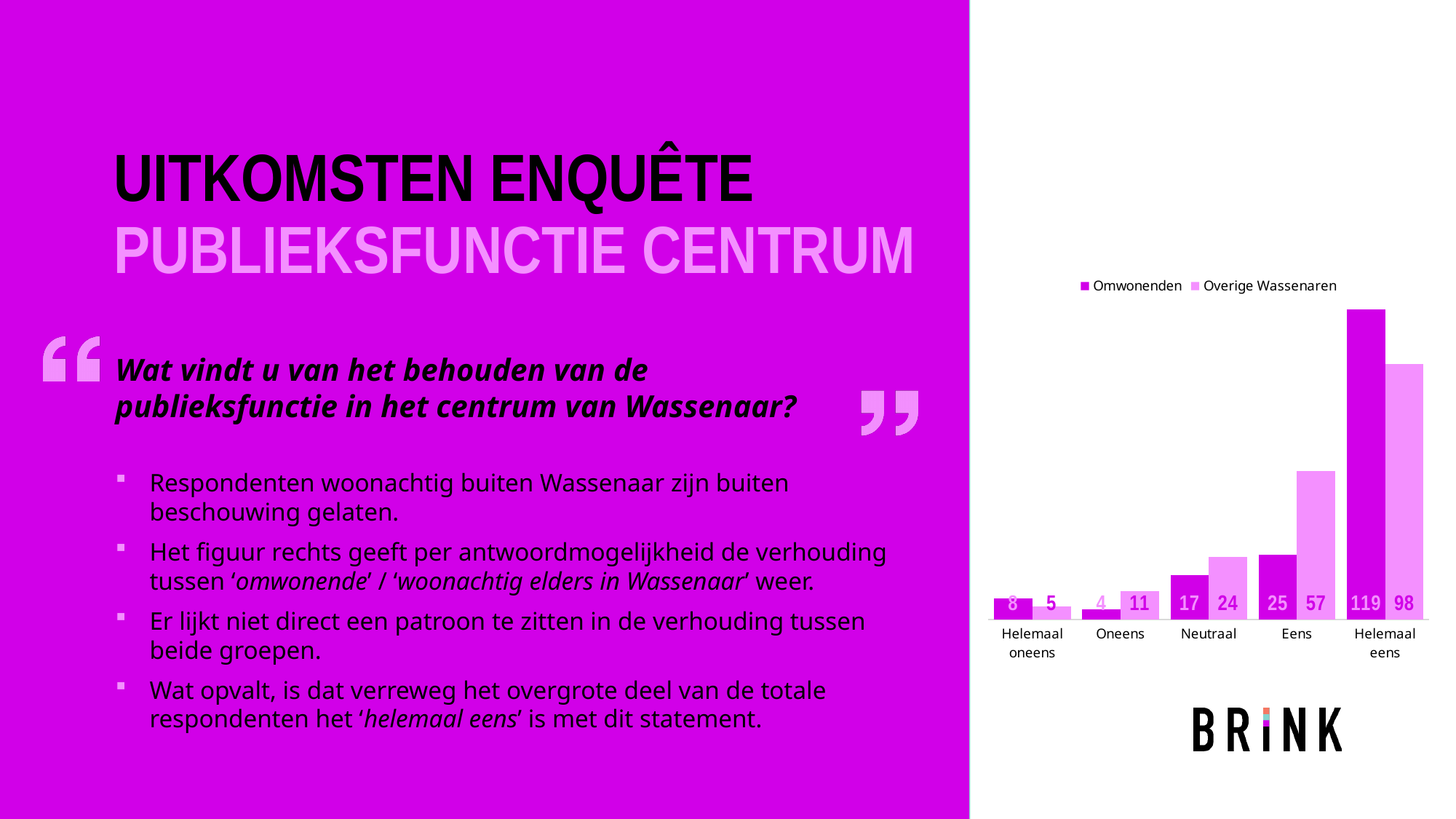
Which series has the larger value in the Helemaal eens category, Omwonenden or Overige Wassenaren? Omwonenden What is the value for Overige Wassenaren in the Eens category? 57 What is the value for Omwonenden in the Helemaal eens category? 119 What is the value for Omwonenden in the Neutraal category? 17 What is the difference between Overige Wassenaren and Omwonenden in the Eens category? 32 How many categories are shown on the x axis of the chart? 5 Do the values for Overige Wassenaren rise or fall from Oneens to Helemaal eens? Rise Which category has the lowest value for Overige Wassenaren? Helemaal oneens How many series does the chart legend list? 2 Which category has the highest value for Omwonenden? Helemaal eens What is the value for Overige Wassenaren in the Oneens category? 11 What kind of chart is shown on the slide? Bar chart